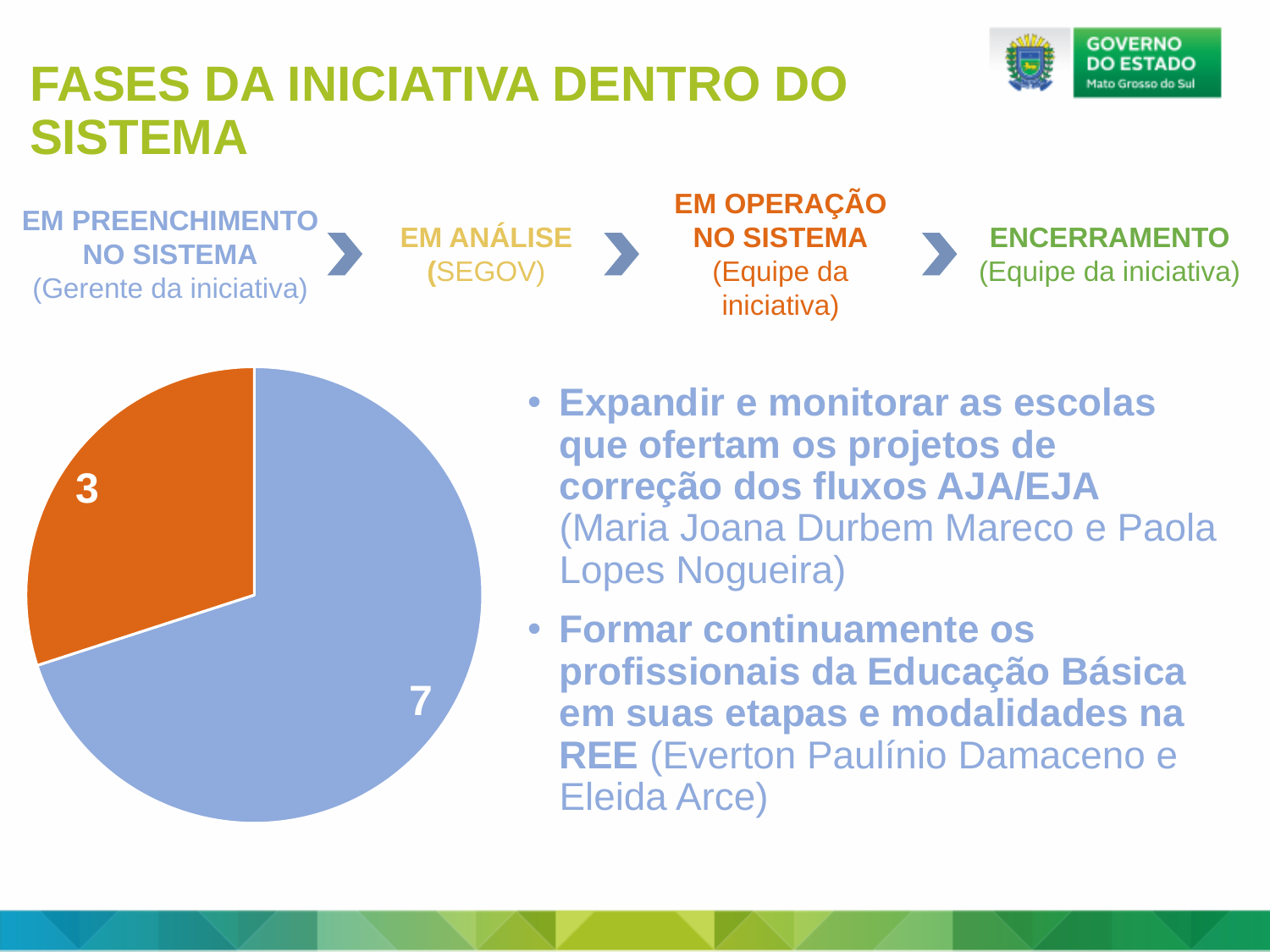
What share of the pie does the orange slice (3) represent? 30% What kind of chart is shown on the slide? pie chart How many slices does the pie chart have? 2 What value is labelled on the orange slice of the pie chart? 3 What is the difference between the values of the blue slice and the orange slice? 4 Which slice of the pie chart is the largest? the blue slice (7) What is the total of the values shown in the pie chart? 10 What two colours are used for the slices of the pie chart? blue and orange Which is larger in the pie chart, the blue slice or the orange slice? the blue slice Which slice of the pie chart is the smallest? the orange slice (3) What share of the pie does the blue slice (7) represent? 70% What value is labelled on the blue slice of the pie chart? 7